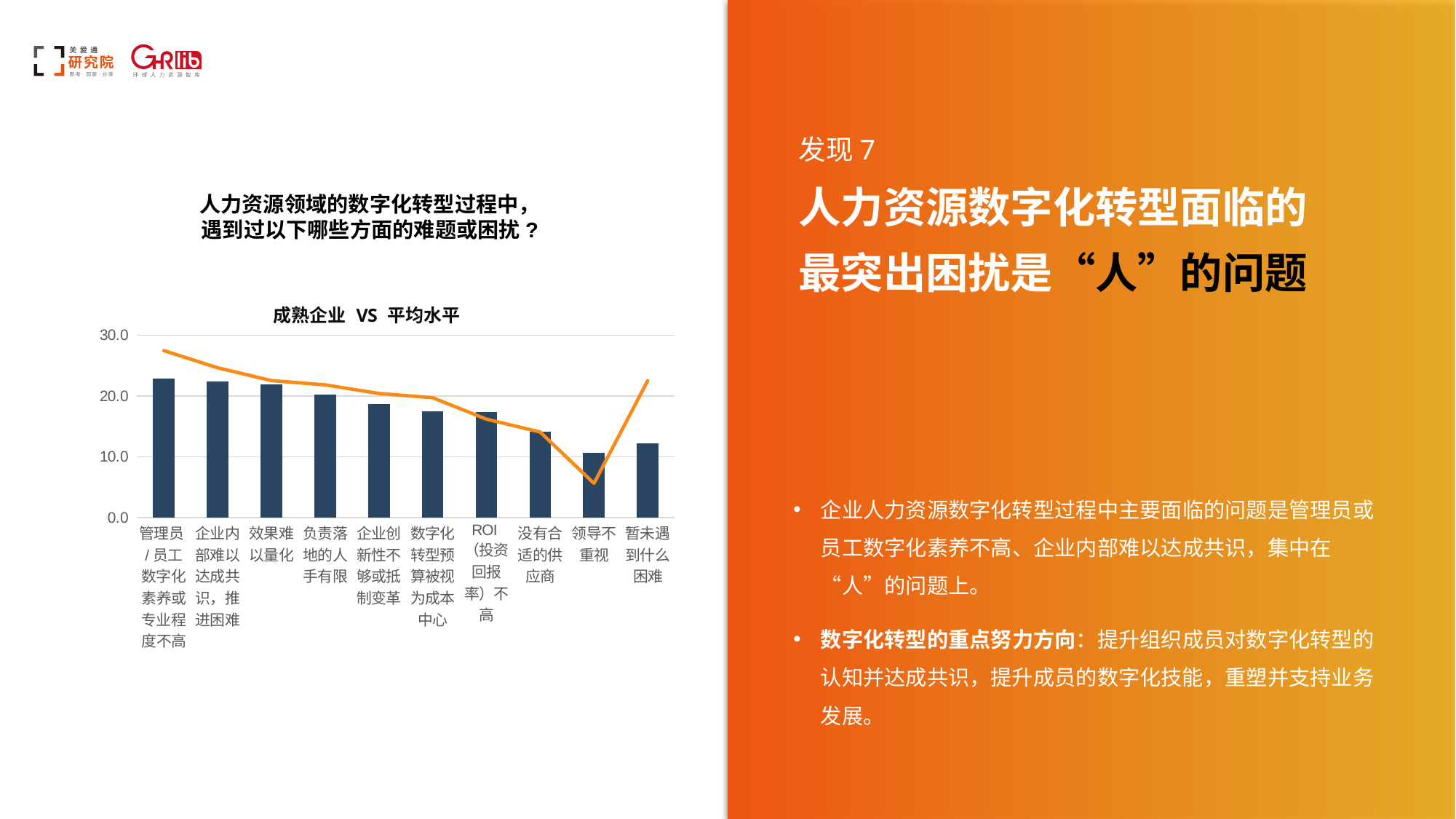
What kind of chart is shown on the slide? Bar chart with a line overlay Is the bar value for 没有合适的供应商 greater or less than 10? greater Which category has the lowest bar in the chart? 领导不重视 What is the highest value shown on the chart's y axis? 30.0 Do the bar values generally rise or fall from 管理员/员工数字化素养或专业程度不高 to 领导不重视 along the x axis? fall Is the bar value for 暂未遇到什么困难 greater or less than 20? less How many categories are shown on the x axis of the chart? 10 What is the title printed directly above the chart? 成熟企业 VS 平均水平 Is the bar value for 领导不重视 greater or less than 20? less Which bar is taller: 负责落地的人手有限 or 没有合适的供应商? 负责落地的人手有限 Which bar is taller: 效果难以量化 or 领导不重视? 效果难以量化